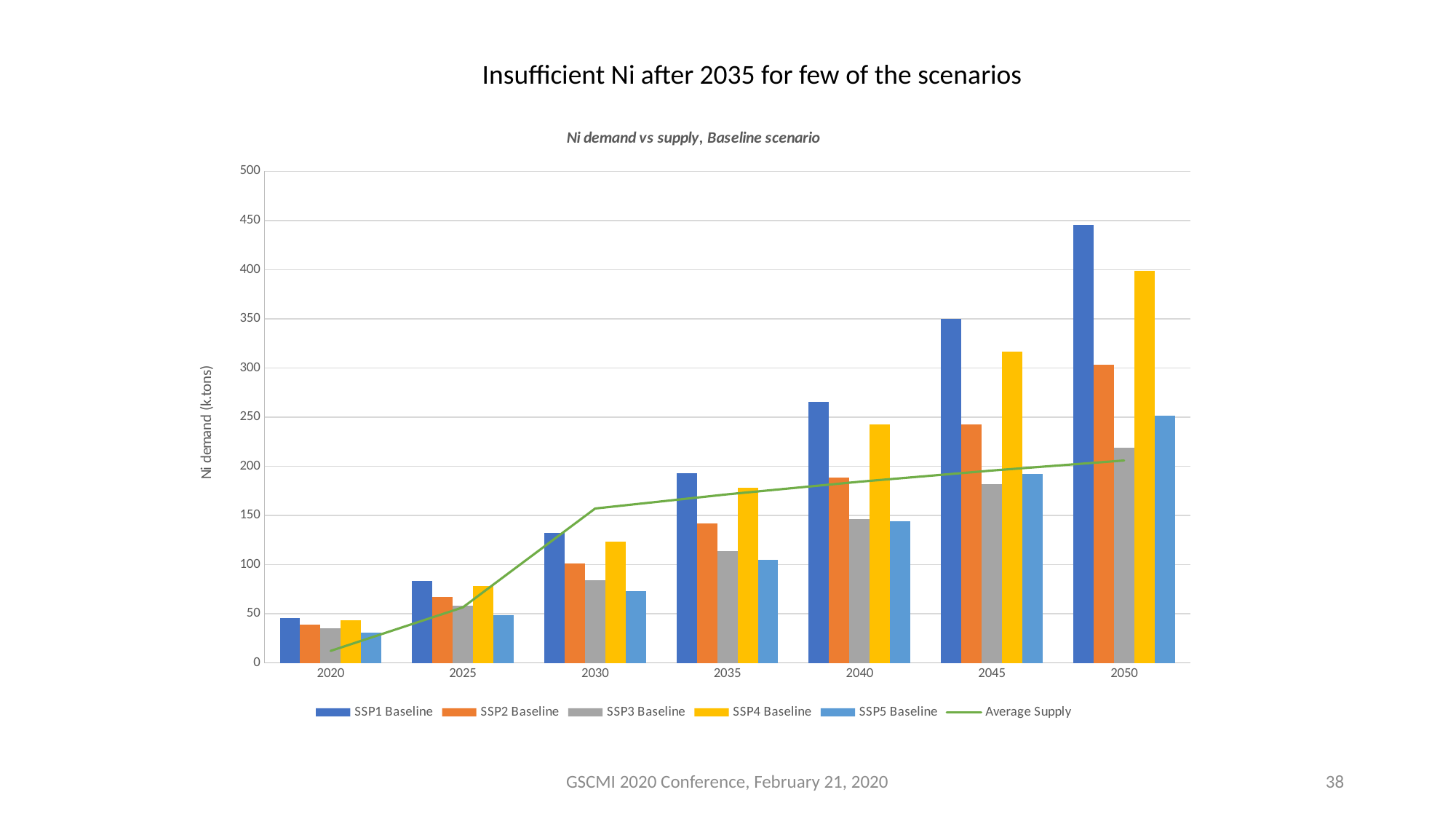
Which series has the lowest bar in 2050? SSP3 Baseline How many years are shown along the x axis? 7 Which series has the highest bar in 2050? SSP1 Baseline In 2050, which is larger: SSP5 Baseline or SSP3 Baseline? SSP5 Baseline Do the SSP1 Baseline values rise or fall from 2020 to 2050? rise How many series does the legend list? 6 Is the value for SSP2 Baseline in 2045 greater or less than 250? less What is the label on the y axis? Ni demand (k.tons) Is the value for SSP4 Baseline in 2045 greater or less than 300? greater What kind of chart is shown on the slide? combination bar and line chart Is the value for SSP1 Baseline in 2050 greater or less than 400? greater In 2040, which is larger: SSP1 Baseline or SSP4 Baseline? SSP1 Baseline